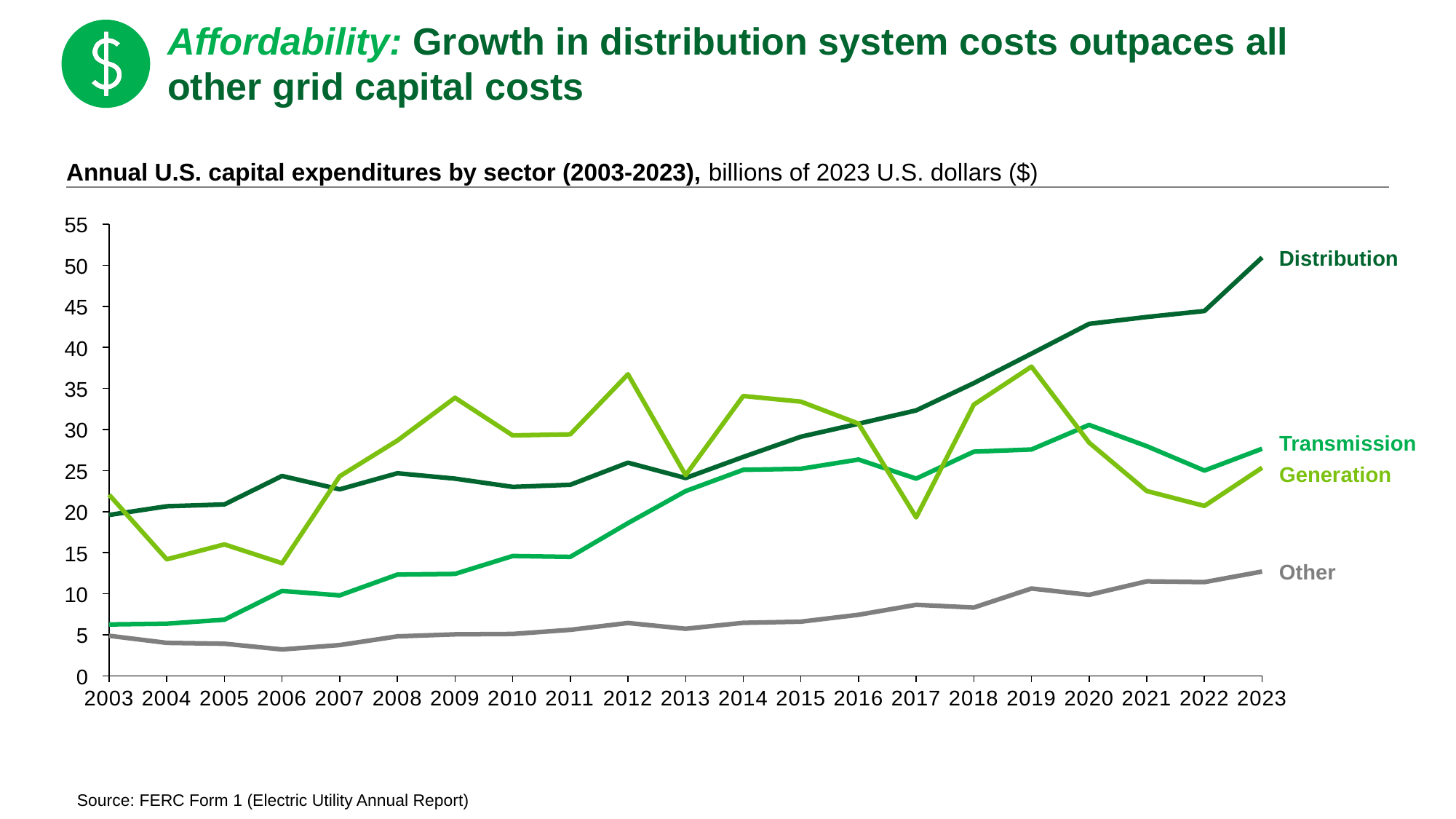
How many years are shown along the x axis of the chart? 21 What is the source cited for the chart? FERC Form 1 (Electric Utility Annual Report) In 2009, which is larger: Generation or Distribution? Generation Which series has the highest value in 2023? Distribution Is the value for Distribution in 2023 greater or less than 45? greater What kind of chart is shown on the slide? Line chart Which series has the highest value in 2012? Generation How many series are plotted on the chart? 4 Is the value for Transmission in 2003 greater or less than 10? less Which series has the lowest value in 2023? Other In 2017, which is larger: Generation or Transmission? Transmission Does the Distribution series generally rise or fall from 2013 to 2023? Rise